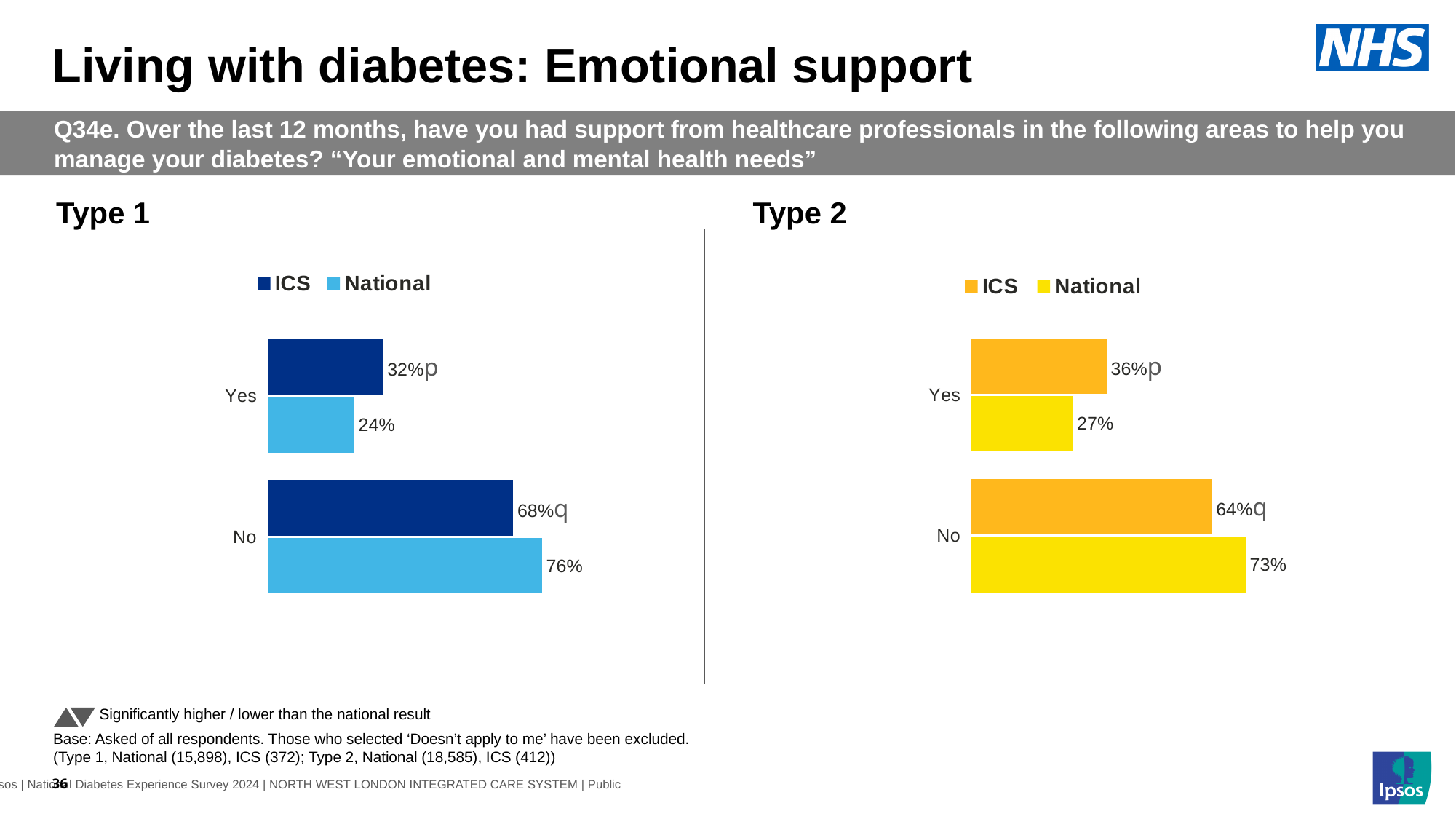
In the Type 2 chart, which is larger for No, ICS or National? National In the Type 2 chart, what is the difference between the ICS and National values for Yes? 9% In the Type 1 chart, what is the difference between the ICS and National values for No? 8% In the Type 2 chart, what is the National value for No? 73% In the Type 1 chart, which category has the lowest National value? Yes In the Type 2 chart, which category has the highest ICS value? No What kind of chart is the Type 2 chart? Bar chart How many series does the legend of the Type 1 chart list? 2 In the Type 2 chart, what is the ICS value for Yes? 36% In the Type 1 chart, which is larger for Yes, ICS or National? ICS In the Type 1 chart, what is the ICS value for Yes? 32% In the Type 1 chart, what is the National value for No? 76%